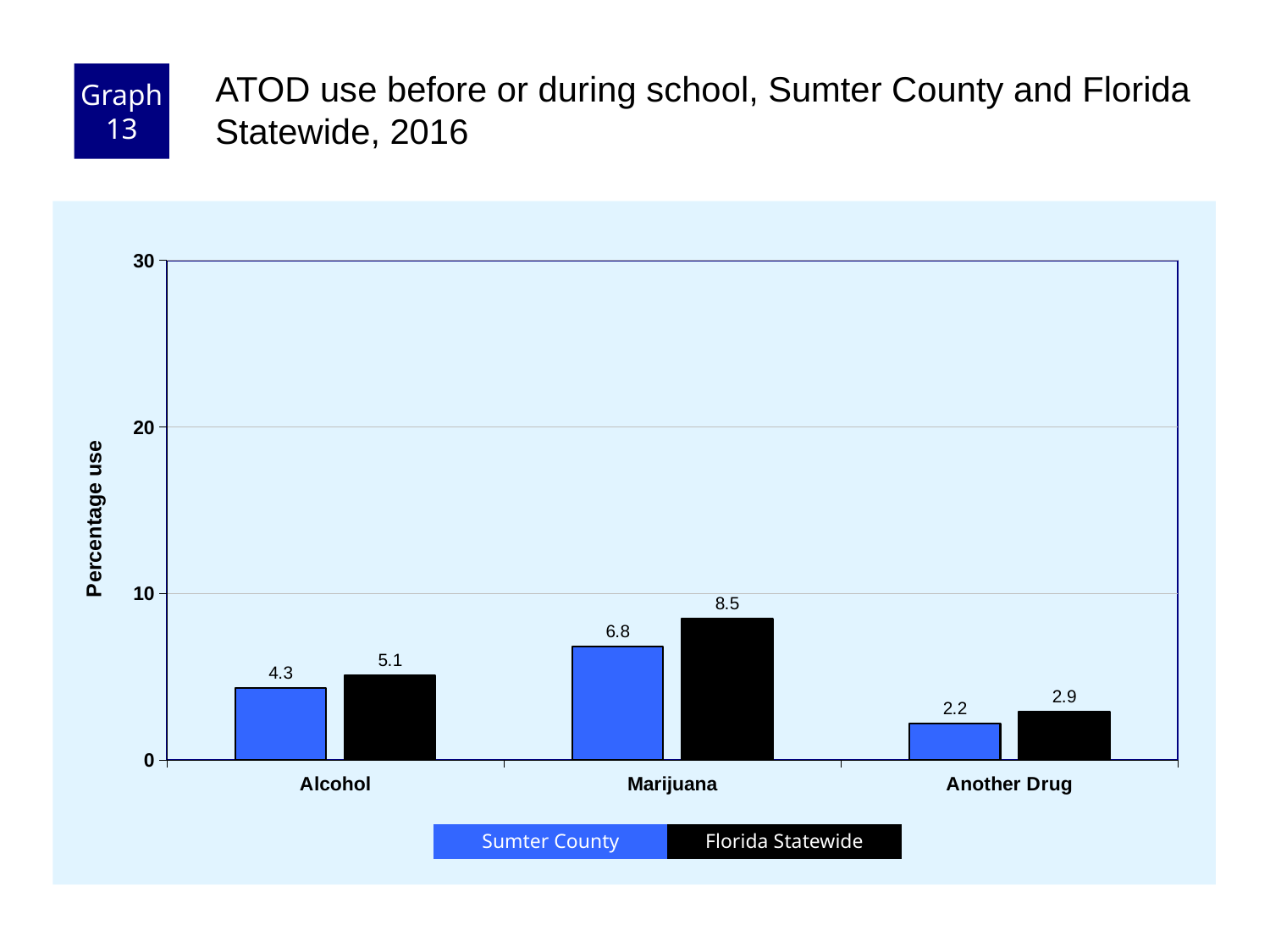
Which is larger for Alcohol: Sumter County or Florida Statewide? Florida Statewide What is the label of the y axis? Percentage use How many series does the legend list? 2 What is the Florida Statewide value for Marijuana? 8.5 What is the Sumter County value for Alcohol? 4.3 Which category has the highest Florida Statewide value? Marijuana What kind of chart is shown? bar chart How many categories are shown on the x axis? 3 Which category has the lowest Sumter County value? Another Drug What is the Sumter County value for Another Drug? 2.2 Is the Florida Statewide value for Marijuana greater or less than 10? less What is the difference between the Florida Statewide and Sumter County values for Marijuana? 1.7